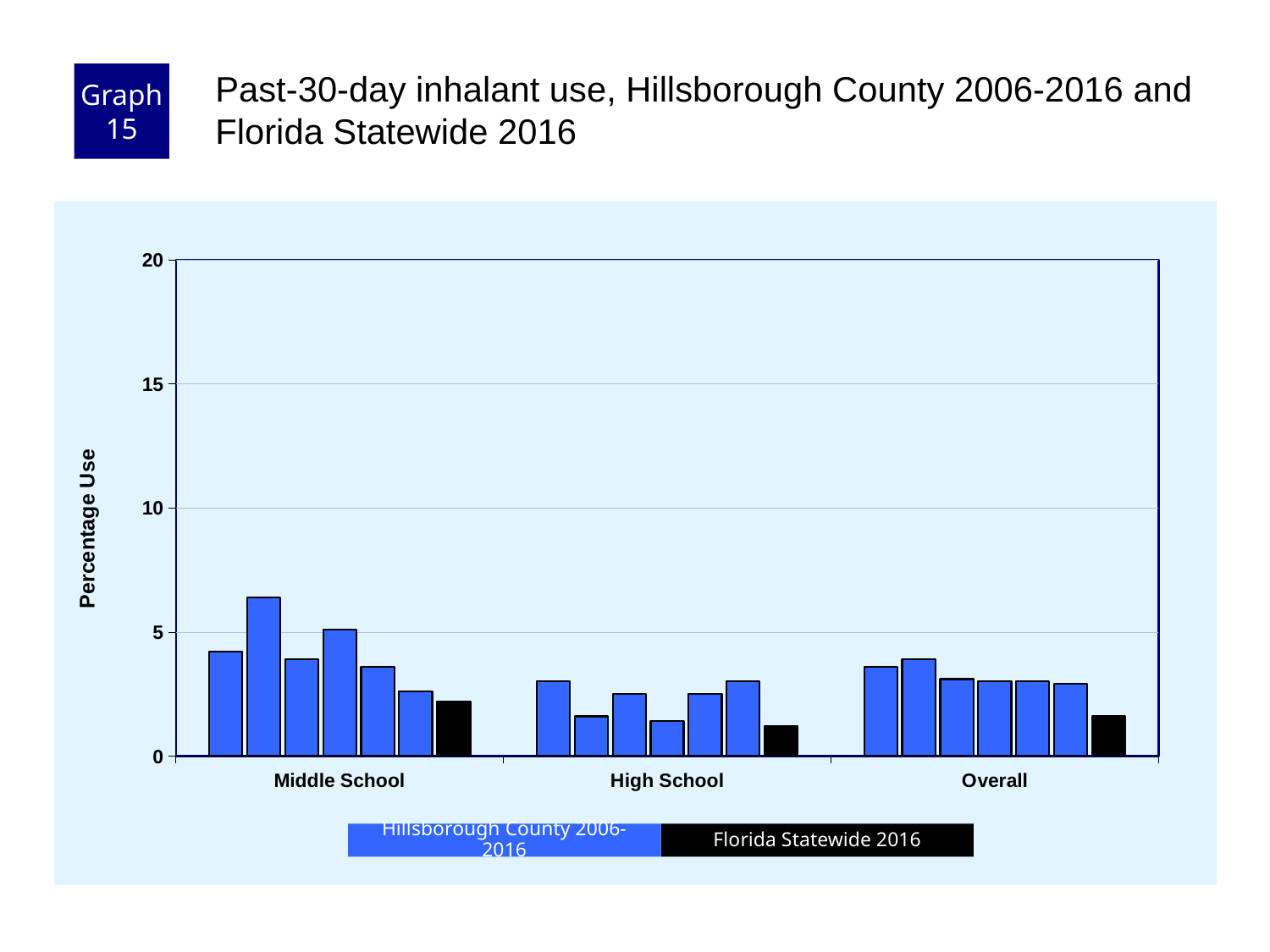
Is the Florida Statewide 2016 bar larger for Middle School or for High School? Middle School Is the Florida Statewide 2016 bar for High School greater or less than 5? less Which x-axis group contains the tallest bar in the chart? Middle School Is the tallest bar in the Overall group greater or less than 5? less How many series does the chart legend list? 2 What kind of chart is shown on the slide? bar chart What is the label on the y axis of the chart? Percentage Use Are any bars in the chart greater than 10? no How many bars are shown in the High School group? 7 Which colour represents Florida Statewide 2016 in the chart? black How many categories are shown on the x axis of the chart? 3